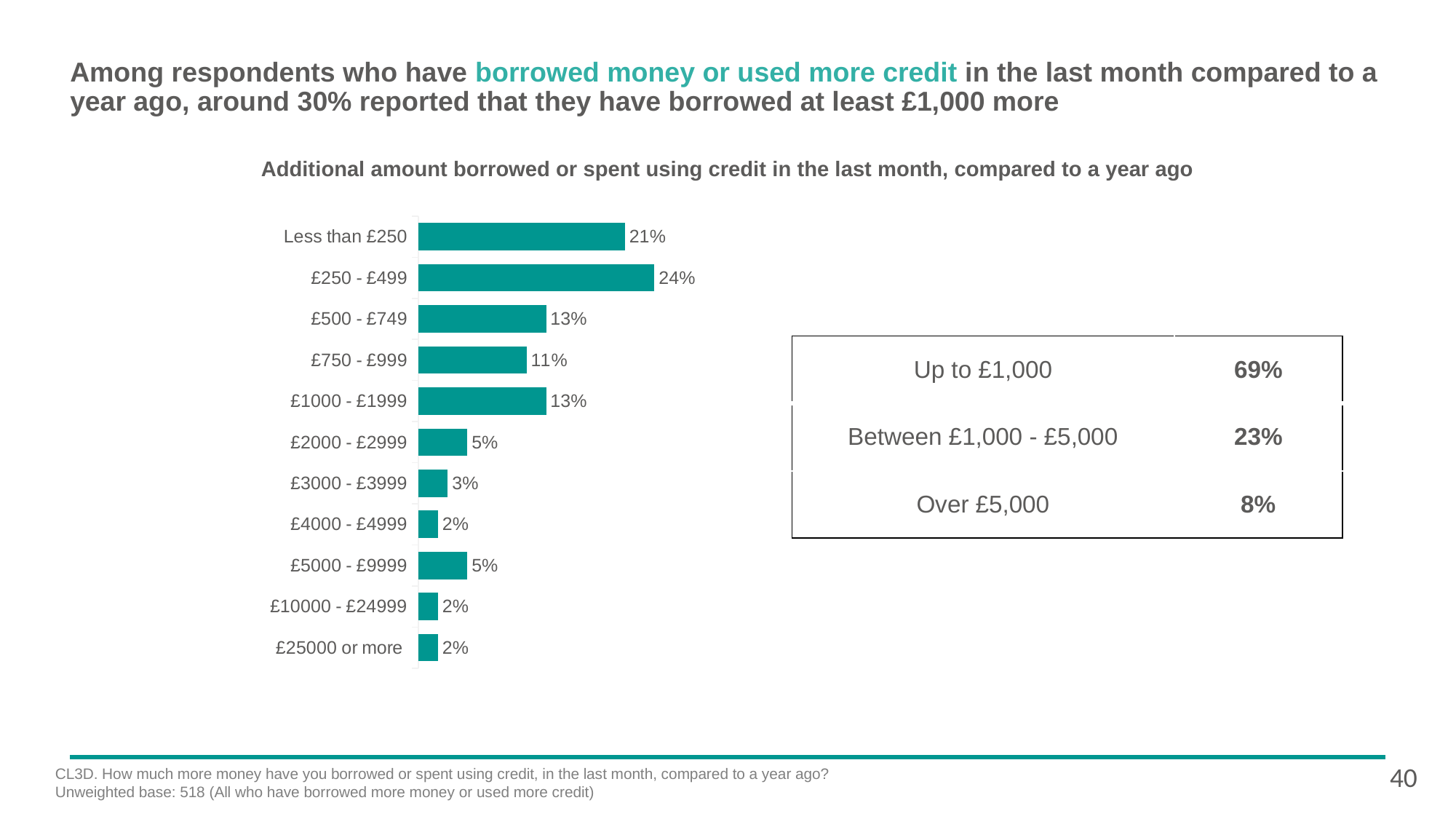
What kind of chart is shown on the slide? Bar chart What is the difference between the values for £500 - £749 and £3000 - £3999? 10% What is the title of the chart? Additional amount borrowed or spent using credit in the last month, compared to a year ago What is the value for £25000 or more? 2% Which is larger, the value for £1000 - £1999 or the value for £5000 - £9999? £1000 - £1999 Which category has the highest value? £250 - £499 What is the difference between the values for £250 - £499 and Less than £250? 3% What is the value for £2000 - £2999? 5% Which is larger, the value for Less than £250 or the value for £750 - £999? Less than £250 What is the value for £750 - £999? 11% How many categories are shown in the chart? 11 What is the value for £250 - £499? 24%